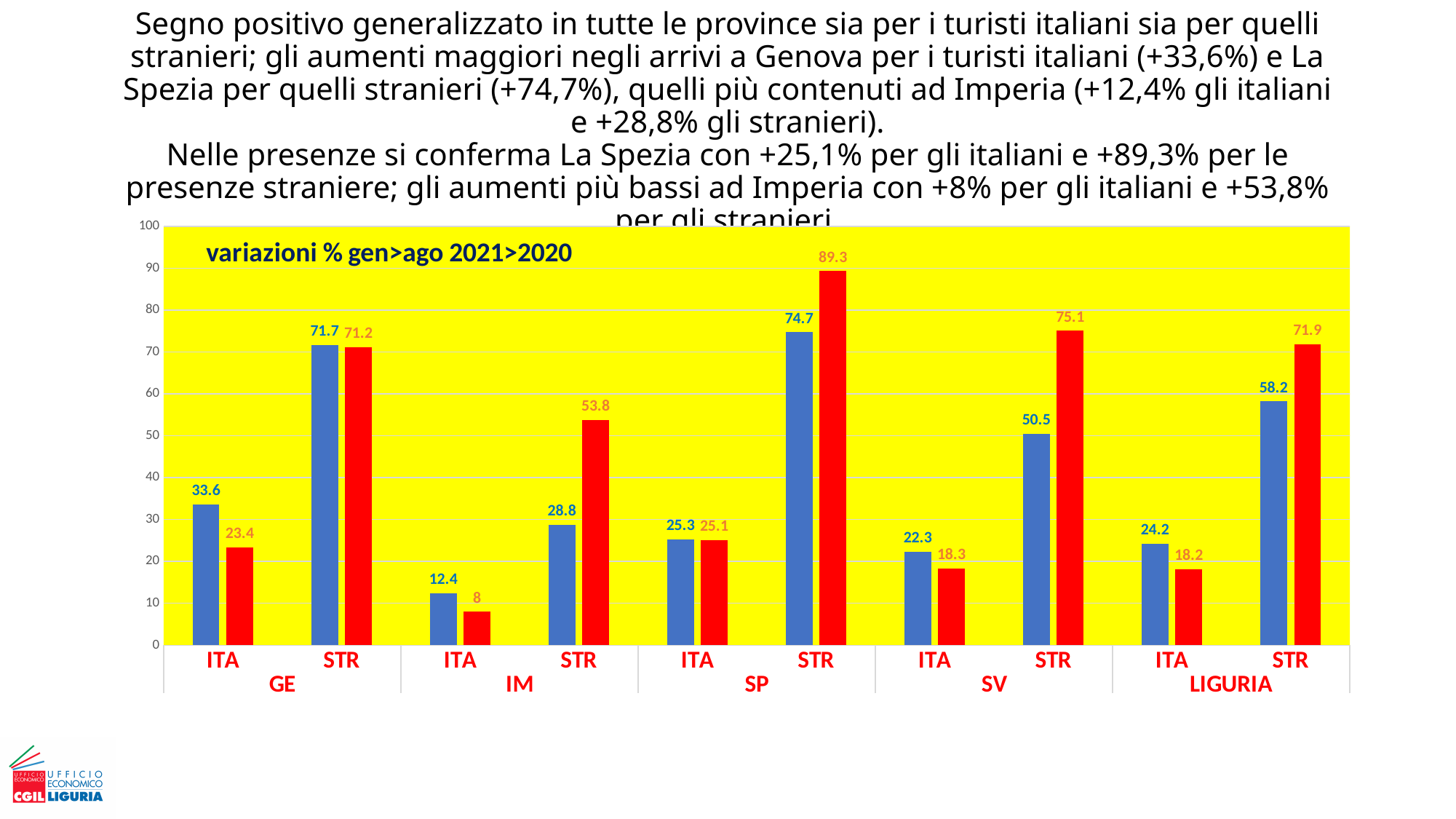
Which group and category has the lowest blue bar? IM ITA In the SP group, what is the difference between the red bar and the blue bar for STR? 14.6 What is the value of the red bar for ITA in the IM group? 8 What is the value of the blue bar for STR in the LIGURIA group? 58.2 What is the value of the blue bar for ITA in the GE group? 33.6 Which group and category has the highest red bar? SP STR What is the value of the red bar for STR in the SP group? 89.3 In the IM group, which is larger for STR: the blue bar or the red bar? the red bar What is the title printed inside the chart area? variazioni % gen>ago 2021>2020 How many province groups are shown on the x axis? 5 What kind of chart is shown on the slide? bar chart Is the value of the red bar for STR in the SV group greater or less than 70? greater